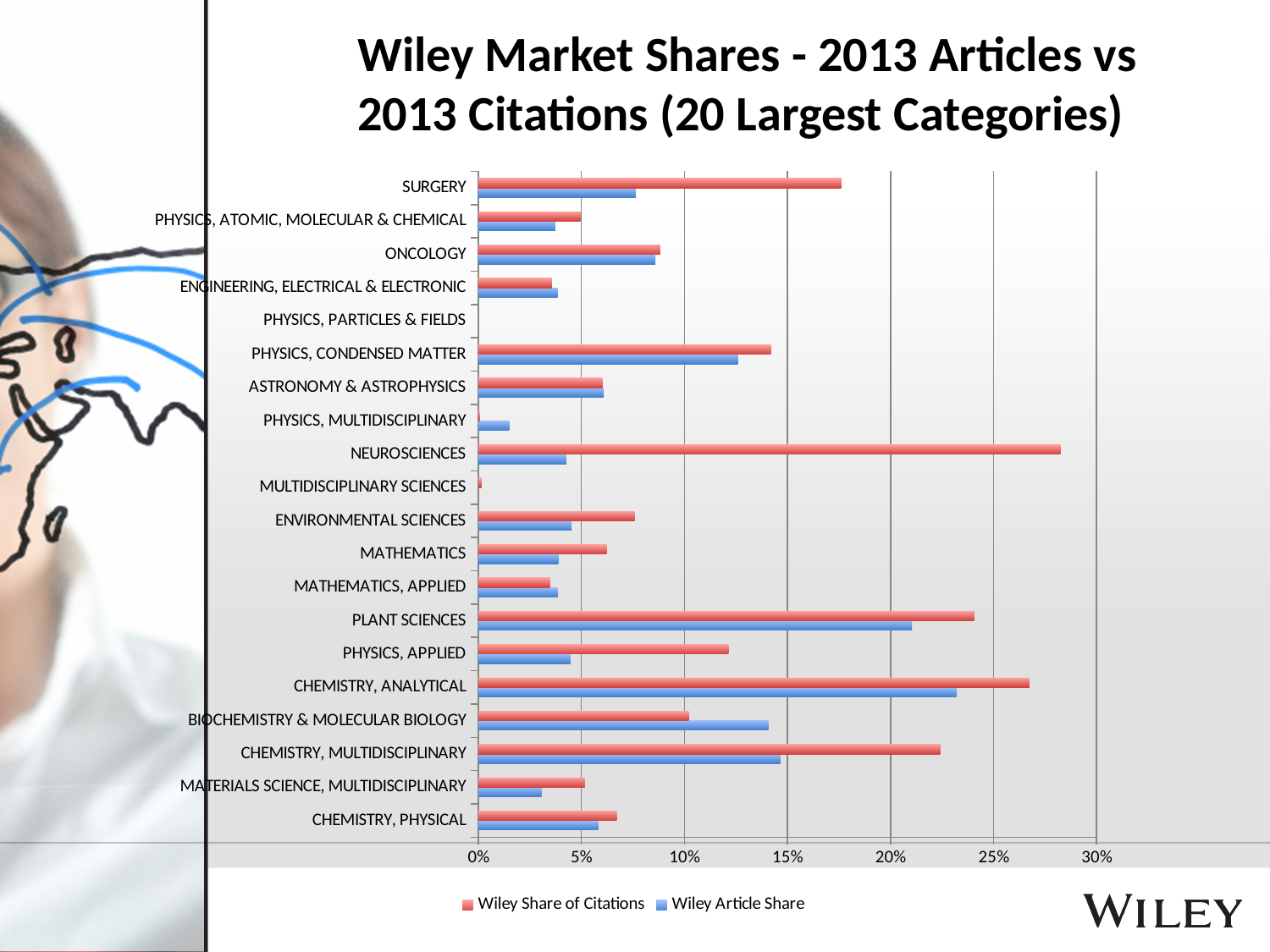
For PHYSICS, APPLIED, which is larger: Wiley Share of Citations or Wiley Article Share? Wiley Share of Citations Which category has the highest Wiley Article Share? CHEMISTRY, ANALYTICAL How many series does the legend list? 2 What kind of chart is shown on the slide? Bar chart For BIOCHEMISTRY & MOLECULAR BIOLOGY, which is larger: Wiley Share of Citations or Wiley Article Share? Wiley Article Share Is the Wiley Share of Citations for PLANT SCIENCES greater or less than 20%? greater Is the Wiley Share of Citations for NEUROSCIENCES greater or less than 25%? greater Is the Wiley Article Share for SURGERY greater or less than 10%? less Which colour represents Wiley Article Share in the chart? Blue Which category has the highest Wiley Share of Citations? NEUROSCIENCES What is the title of the chart? Wiley Market Shares - 2013 Articles vs 2013 Citations (20 Largest Categories) How many categories are shown on the chart? 20